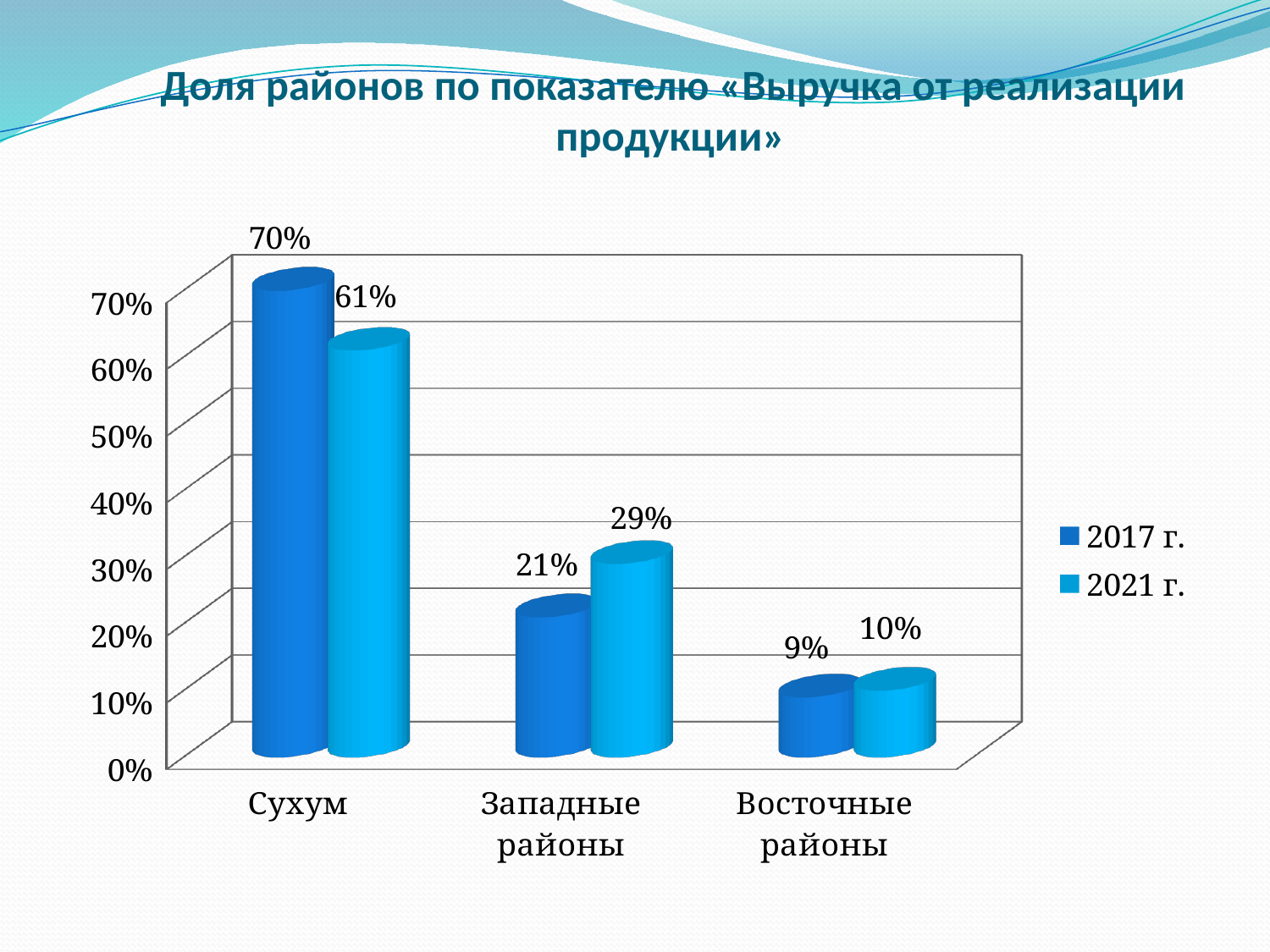
What is the value for Сухум in 2017 г.? 70% What is the value for Восточные районы in 2017 г.? 9% Which category has the lowest value in 2017 г.? Восточные районы What is the value for Западные районы in 2021 г.? 29% Which category has the highest value in 2021 г.? Сухум What kind of chart is shown on the slide? Bar chart Which is larger for Западные районы: the 2017 г. value or the 2021 г. value? 2021 г. How many categories are shown on the x axis? 3 What is the title of the chart? Доля районов по показателю «Выручка от реализации продукции» What is the difference between the 2021 г. and 2017 г. values for Западные районы? 8% What is the difference between the 2017 г. and 2021 г. values for Сухум? 9% How many series does the legend list? 2